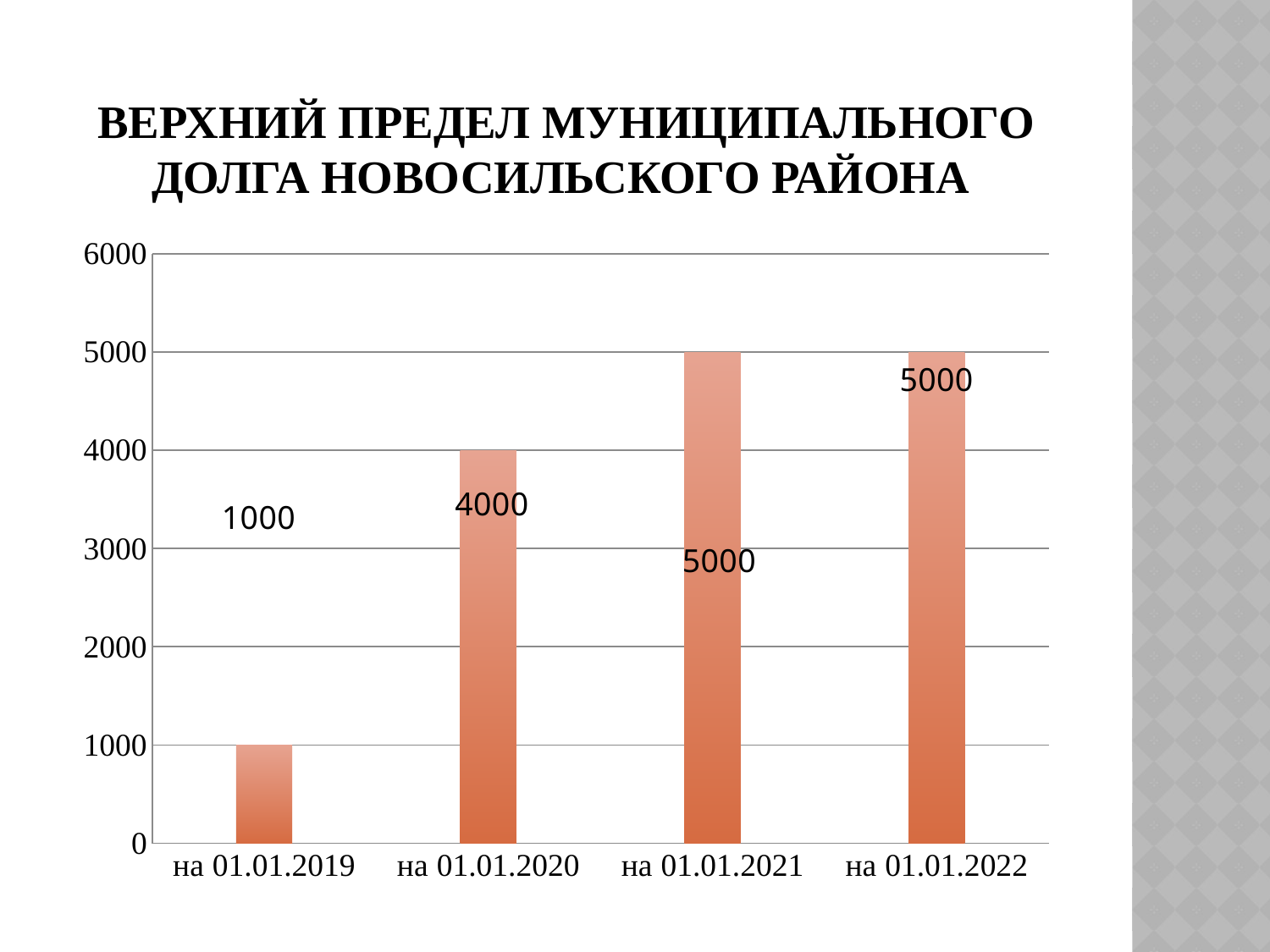
What kind of chart is shown on the slide? bar chart Is the value for на 01.01.2020 greater or less than 3000? greater What is the value for на 01.01.2022? 5000 What is the value for на 01.01.2021? 5000 What is the value for на 01.01.2020? 4000 Which category has the lowest value? на 01.01.2019 What is the difference between the values for на 01.01.2020 and на 01.01.2019? 3000 How many categories are shown on the x axis? 4 What is the value for на 01.01.2019? 1000 What is the difference between the values for на 01.01.2021 and на 01.01.2020? 1000 Which is larger, the value for на 01.01.2020 or the value for на 01.01.2019? на 01.01.2020 Do the values rise or fall from на 01.01.2019 to на 01.01.2021? rise